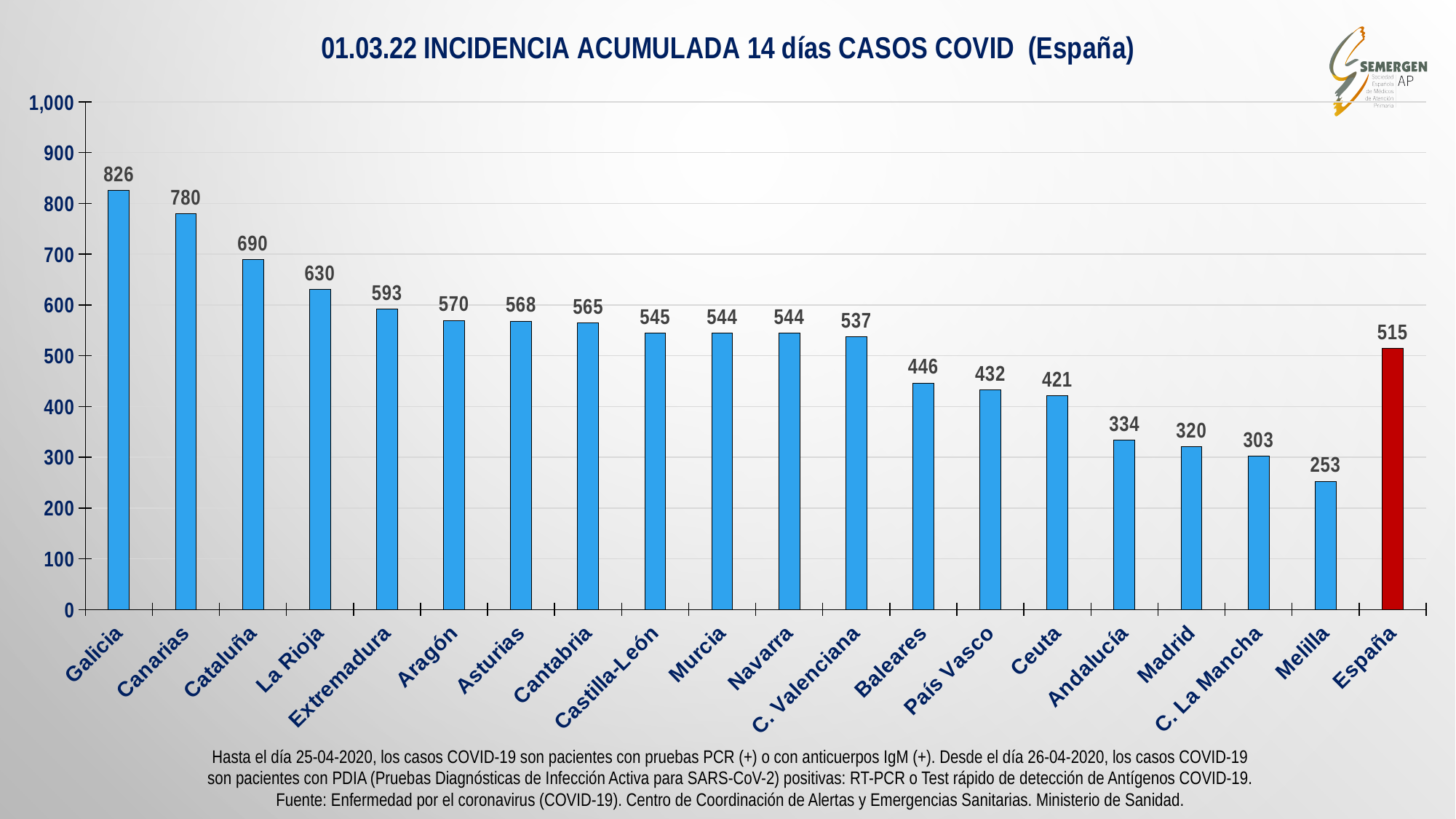
What is the value for España? 515 Which category has the lowest value? Melilla Is the value for Madrid greater or less than 400? less What is the value for Melilla? 253 What kind of chart is shown on the slide? bar chart Which is larger, the value for Baleares or the value for Ceuta? Baleares What is the difference between the values for Galicia and Canarias? 46 Which category has the highest value? Galicia What is the difference between the values for Cataluña and España? 175 Which bar is coloured red instead of blue? España How many categories are shown on the x axis? 20 What is the value for Galicia? 826